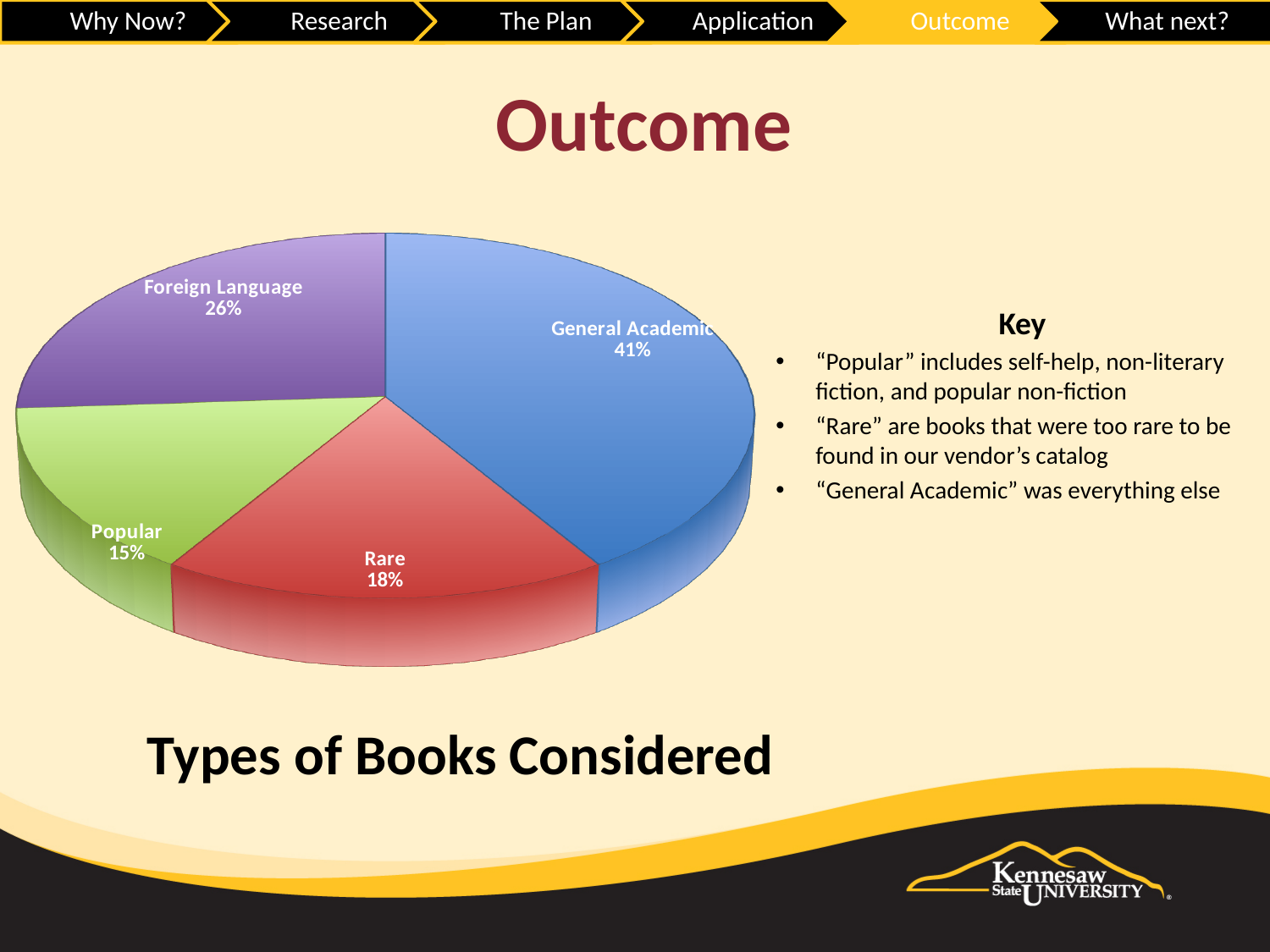
Which category has the largest slice of the pie? General Academic What kind of chart is shown on the slide? Pie chart What share of the pie does Popular represent? 15% What is the difference in percentage points between General Academic and Foreign Language? 15 What share of the pie does Foreign Language represent? 26% What is the difference in percentage points between Rare and Popular? 3 What share of the pie does General Academic represent? 41% Which is larger, the Foreign Language slice or the Rare slice? Foreign Language What colour is the General Academic slice? Blue How many categories are shown in the pie chart? 4 Which category has the smallest slice of the pie? Popular